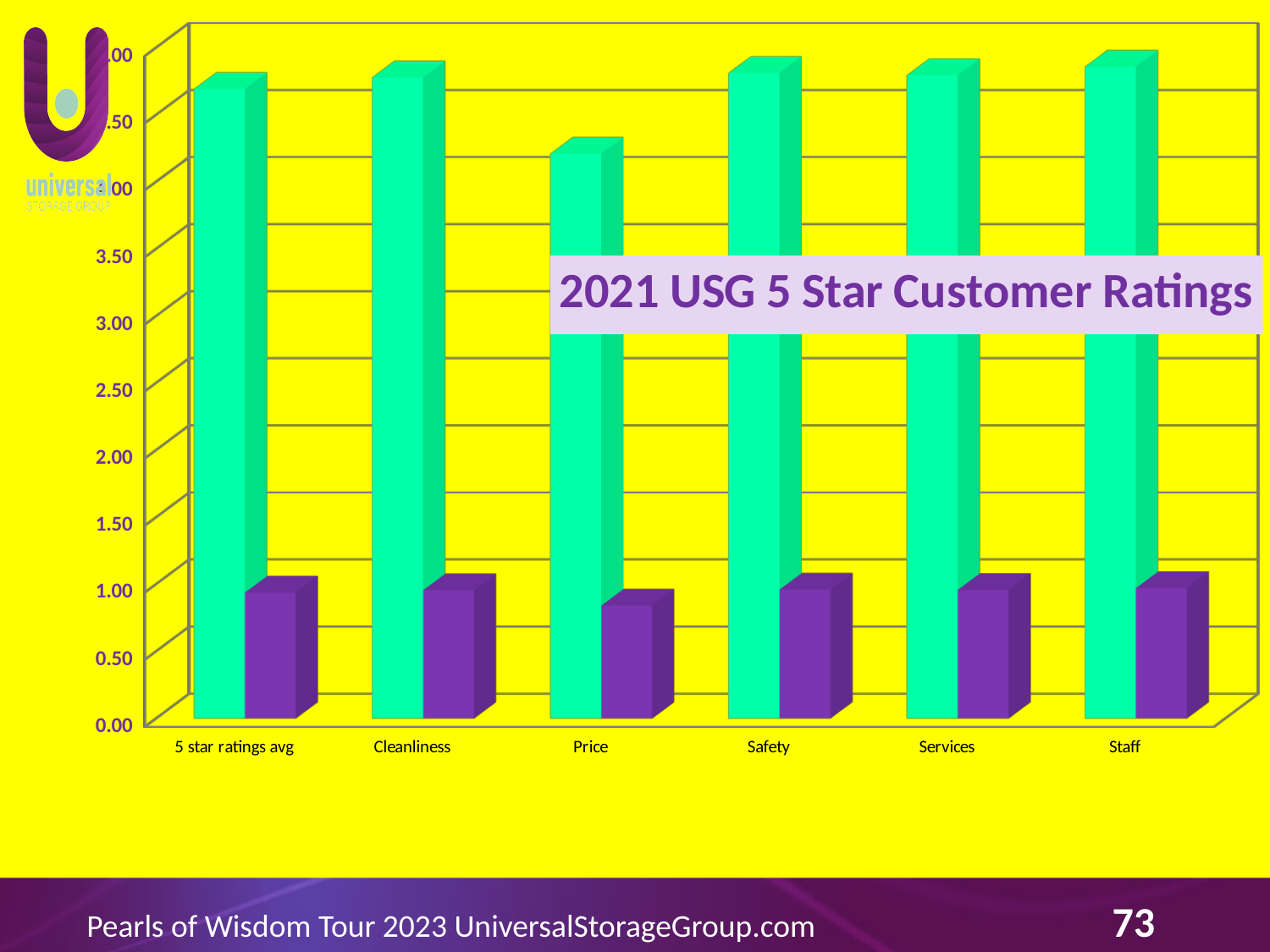
Which category has the lowest purple bar in the chart? Price Which category has the lowest green bar in the chart? Price What is the title of the chart? 2021 USG 5 Star Customer Ratings Is the green bar for Staff greater or less than 4.00? greater Is the purple bar for Price greater or less than 1.00? less Is the green bar for Price greater or less than 4.50? less How many categories are shown on the x axis of the chart? 6 How many bars are plotted for each category in the chart? 2 What kind of chart is shown on the slide? bar chart Which has the taller green bar, Price or Safety? Safety What colours are the two series of bars in the chart? green and purple